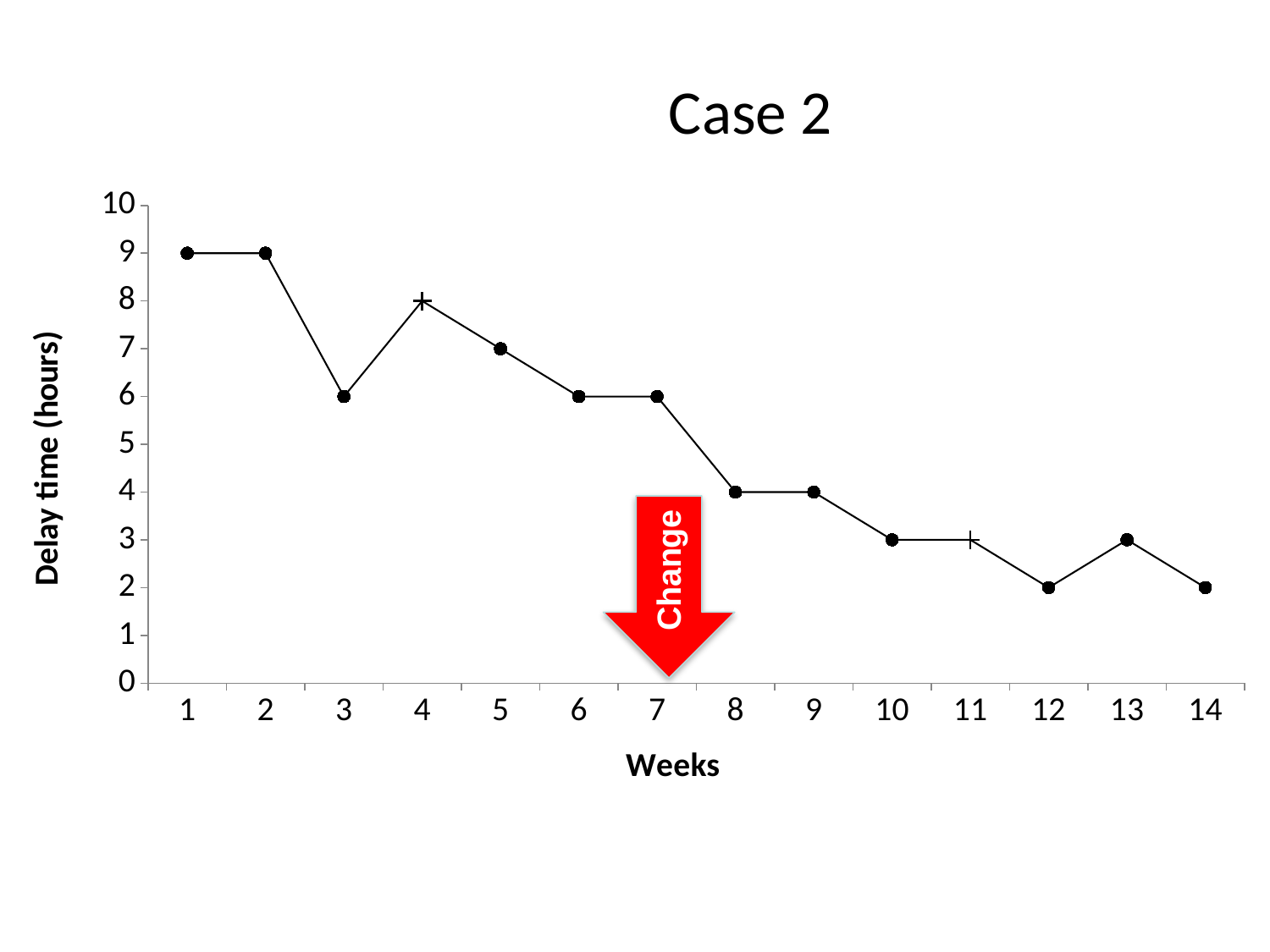
What is the delay time in week 8? 4 Which week has the lowest delay time? Weeks 12 and 14 Is the delay time in week 10 greater or less than 5? less What kind of chart is shown on the slide? line chart Which has a larger delay time, week 4 or week 5? Week 4 What is the delay time in week 1? 9 Do the delay times generally rise or fall across the weeks? fall What is the difference in delay time between week 2 and week 3? 3 What is the delay time in week 14? 2 What is the delay time in week 3? 6 What is the title of the chart? Case 2 How many weeks are plotted on the x axis? 14